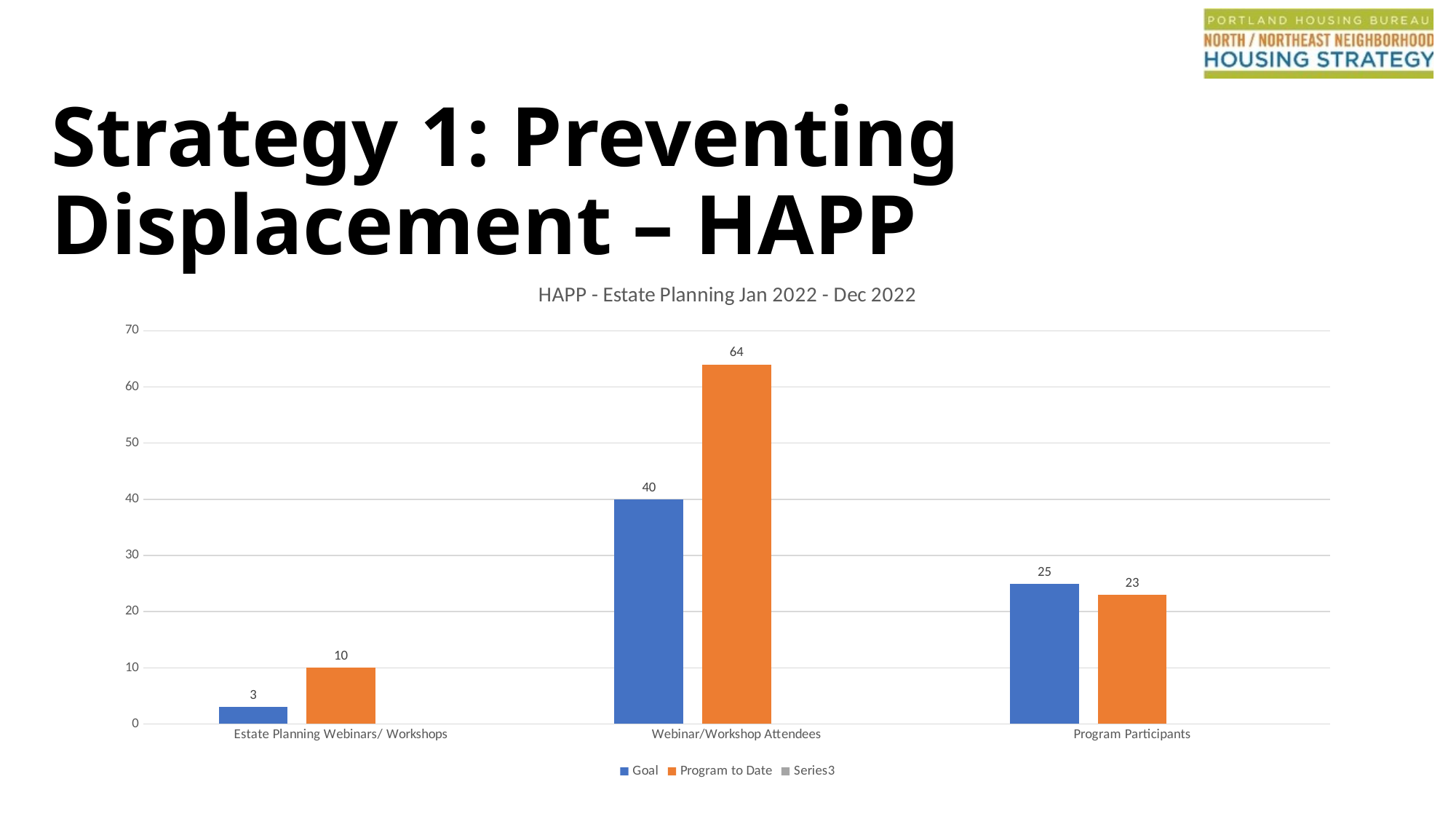
What is the difference between the Program to Date and Goal values for Webinar/Workshop Attendees? 24 What is the Goal value for Webinar/Workshop Attendees? 40 For Program Participants, which is larger: the Goal or the Program to Date value? Goal How many series does the legend list? 3 What kind of chart is shown on the slide? Bar chart What is the title of the chart? HAPP - Estate Planning Jan 2022 - Dec 2022 Which category has the highest Program to Date value? Webinar/Workshop Attendees What is the Program to Date value for Estate Planning Webinars/ Workshops? 10 How many categories are shown on the x axis? 3 What is the Program to Date value for Program Participants? 23 Which category has the lowest Goal value? Estate Planning Webinars/ Workshops Is the Program to Date value for Webinar/Workshop Attendees greater or less than 60? greater